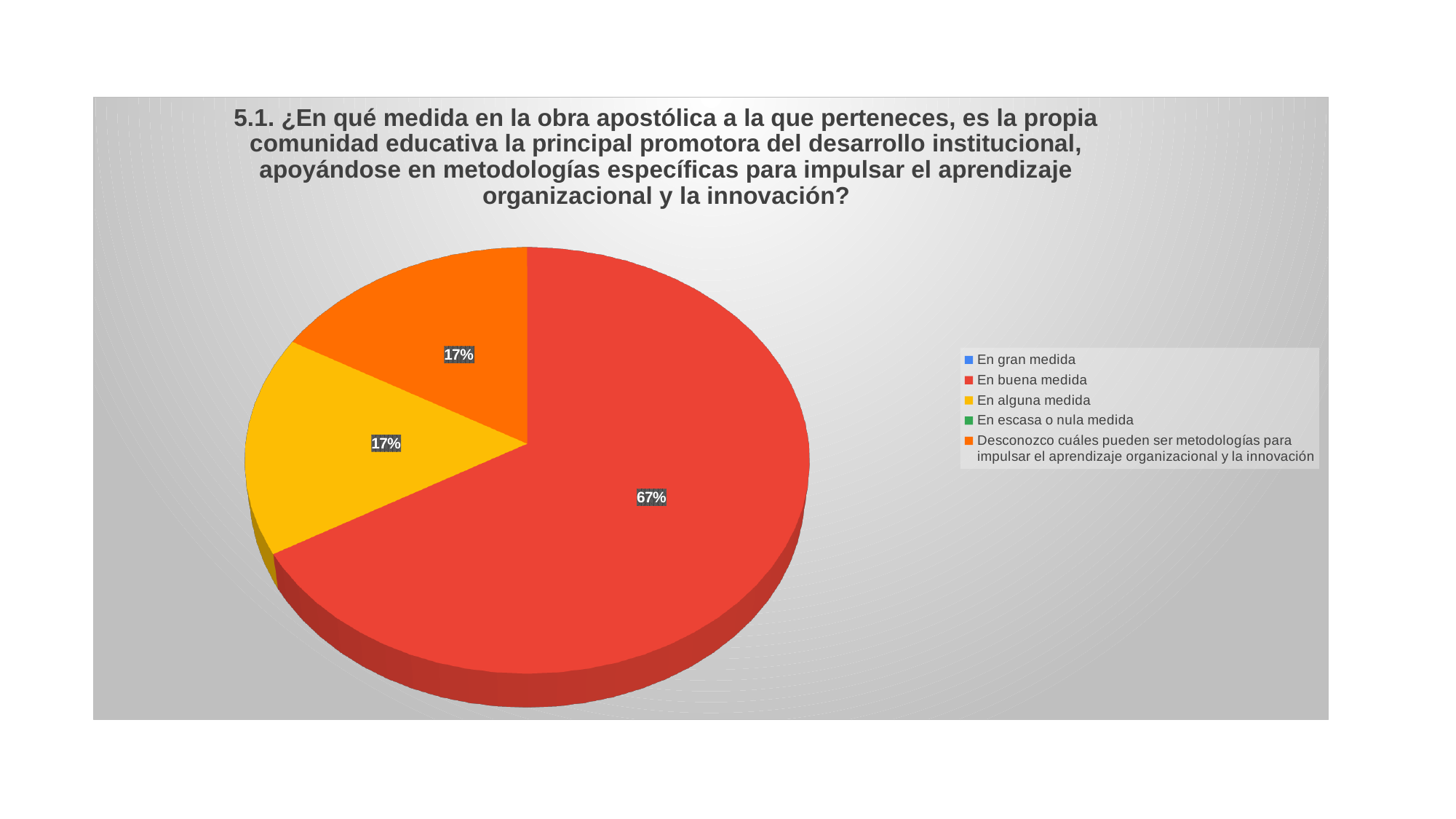
What colour is the slice for "En alguna medida"? Yellow How many entries does the legend list? 5 What share of the pie does "En alguna medida" represent? 17% What kind of chart is shown on the slide? Pie chart Is the share for "En buena medida" greater or less than 50%? greater Which legend entry is shown in red? En buena medida Which category has the largest slice of the pie? En buena medida What share of the pie does "En buena medida" represent? 67% What share of the pie does "Desconozco cuáles pueden ser metodologías para impulsar el aprendizaje organizacional y la innovación" represent? 17% How many slices with a visible share are shown in the pie? 3 What is the difference in percentage points between "En buena medida" and "En alguna medida"? 50 Which is larger, the slice for "En buena medida" or the slice for "En alguna medida"? En buena medida